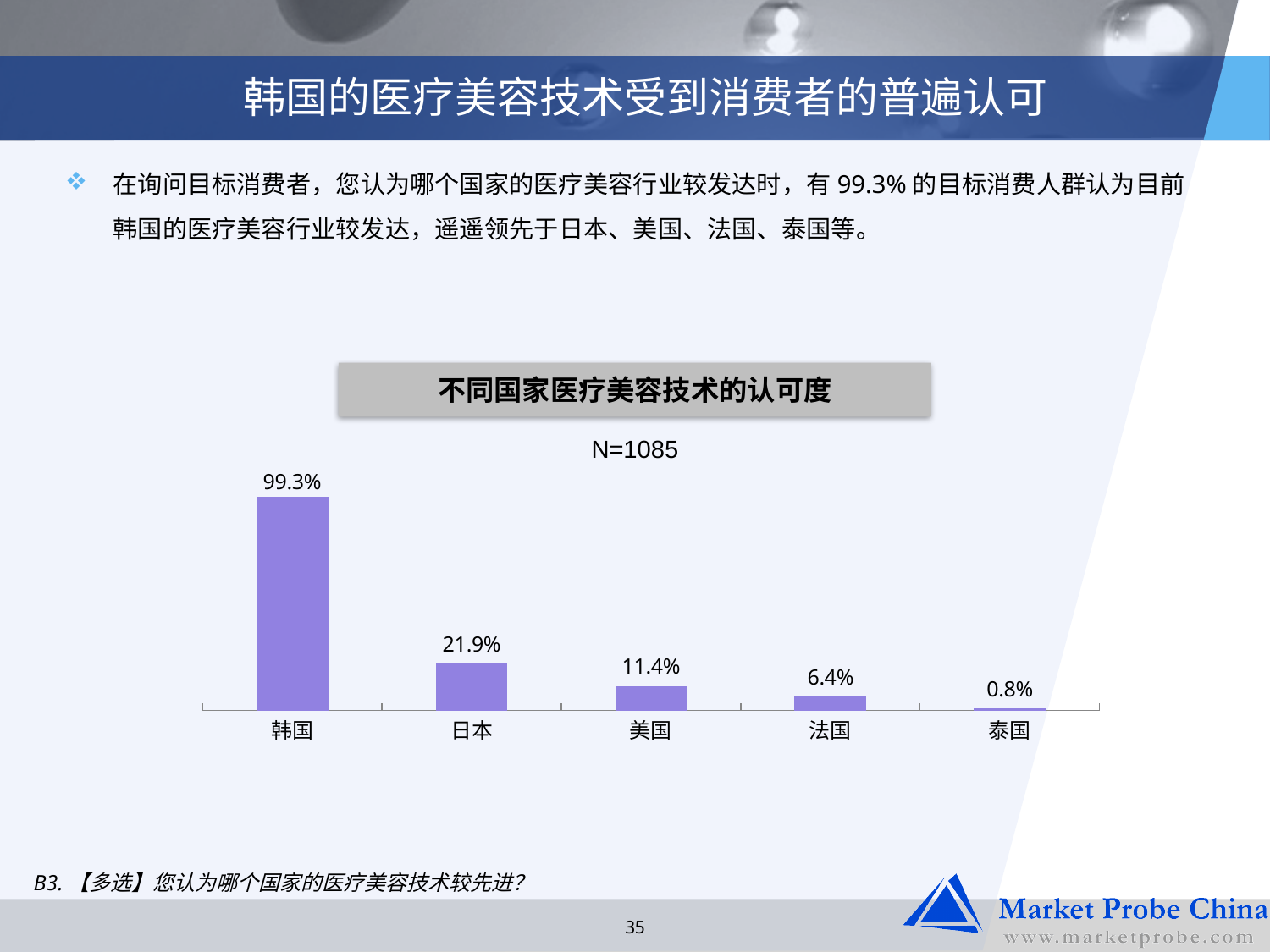
What is the value for 泰国 in the chart? 0.8% Which country has the lowest value in the chart? 泰国 What is the difference between the values for 韩国 and 日本? 77.4% What is the value for 韩国 in the chart? 99.3% What is the title of the chart? 不同国家医疗美容技术的认可度 Which is larger, the value for 日本 or the value for 美国? 日本 What is the difference between the values for 美国 and 法国? 5.0% What is the value for 美国 in the chart? 11.4% What kind of chart is shown on the slide? bar chart How many countries are shown in the chart? 5 Which country has the highest value in the chart? 韩国 What is the value for 日本 in the chart? 21.9%